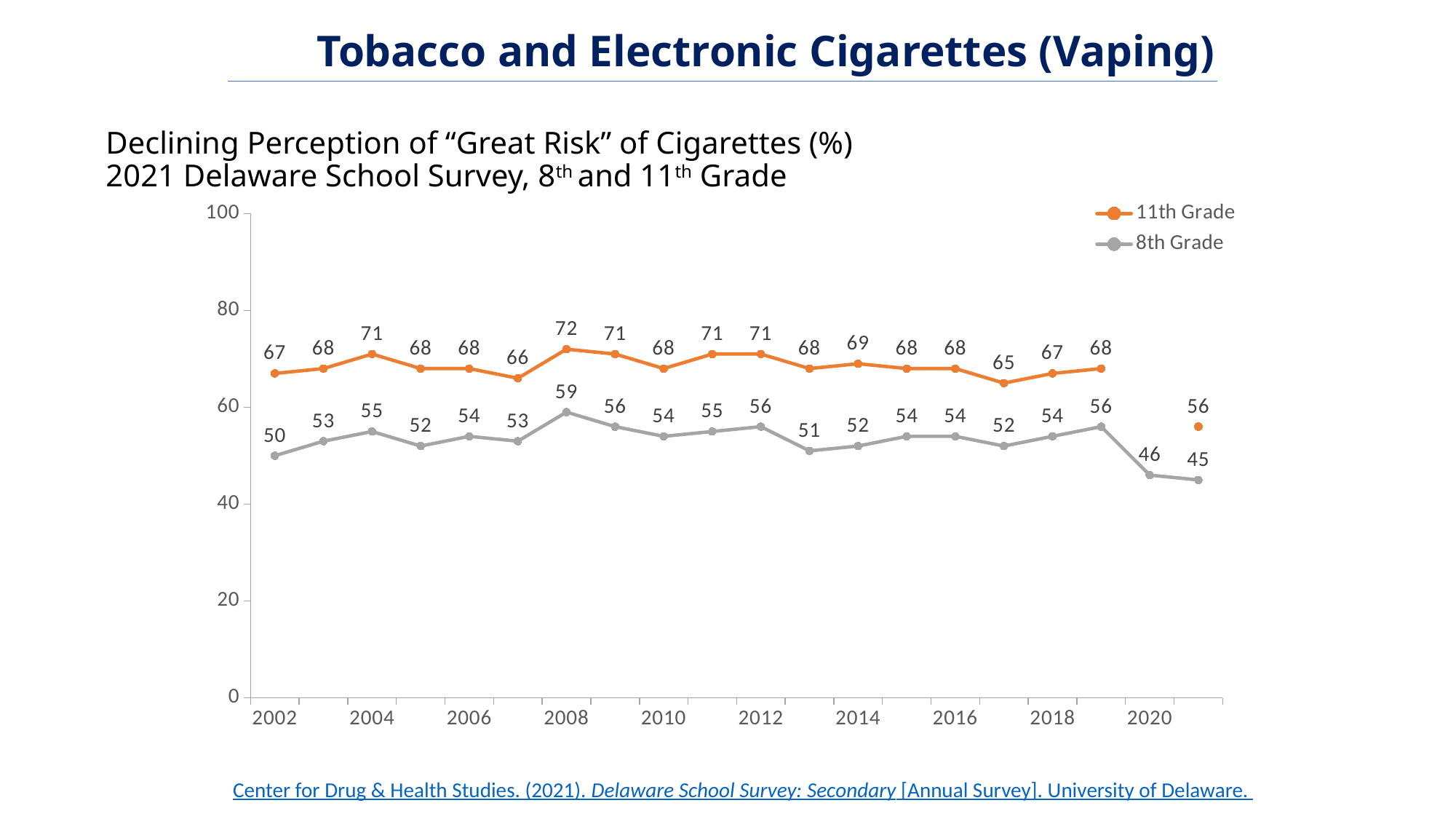
In which year is the 11th Grade value lowest? 2021 What is the 11th Grade value for 2021? 56 In which year is the 8th Grade value highest? 2008 What type of chart is shown on the slide? Line chart What is the 11th Grade value for 2008? 72 What is the 8th Grade value for 2021? 45 What is the difference between the 11th Grade and 8th Grade values in 2002? 17 What is the 8th Grade value for 2013? 51 Is the 8th Grade value for 2020 greater or less than 60? less Which is larger, the 8th Grade value in 2019 or the 8th Grade value in 2020? 2019 How many series does the legend list? 2 Which series is drawn in orange? 11th Grade